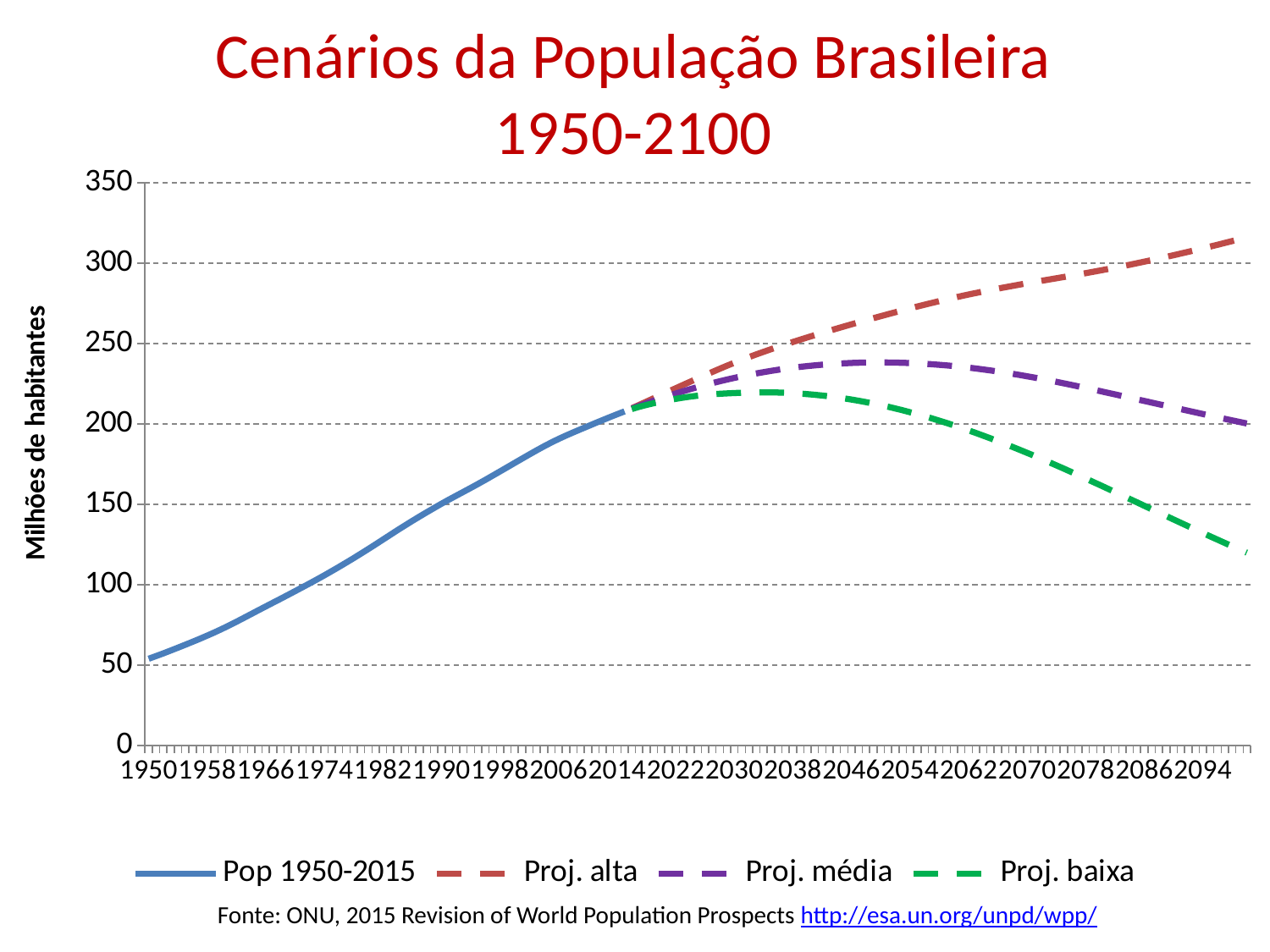
How many series does the legend list? 4 Which series has the lowest value at the right end of the chart (around 2094)? Proj. baixa Is the value of Proj. média at 2054 greater or less than 250? less Does the Pop 1950-2015 series rise or fall from 1950 to 2014? rise At 2070, which is larger: Proj. média or Proj. baixa? Proj. média What is the label of the vertical axis? Milhões de habitantes Is the value of Proj. baixa at 2094 greater or less than 150? less What kind of chart is shown on the slide? line chart Which series has the highest value at the right end of the chart (around 2094)? Proj. alta Is the value of Proj. alta at 2094 greater or less than 300? greater What is the title of the chart? Cenários da População Brasileira 1950-2100